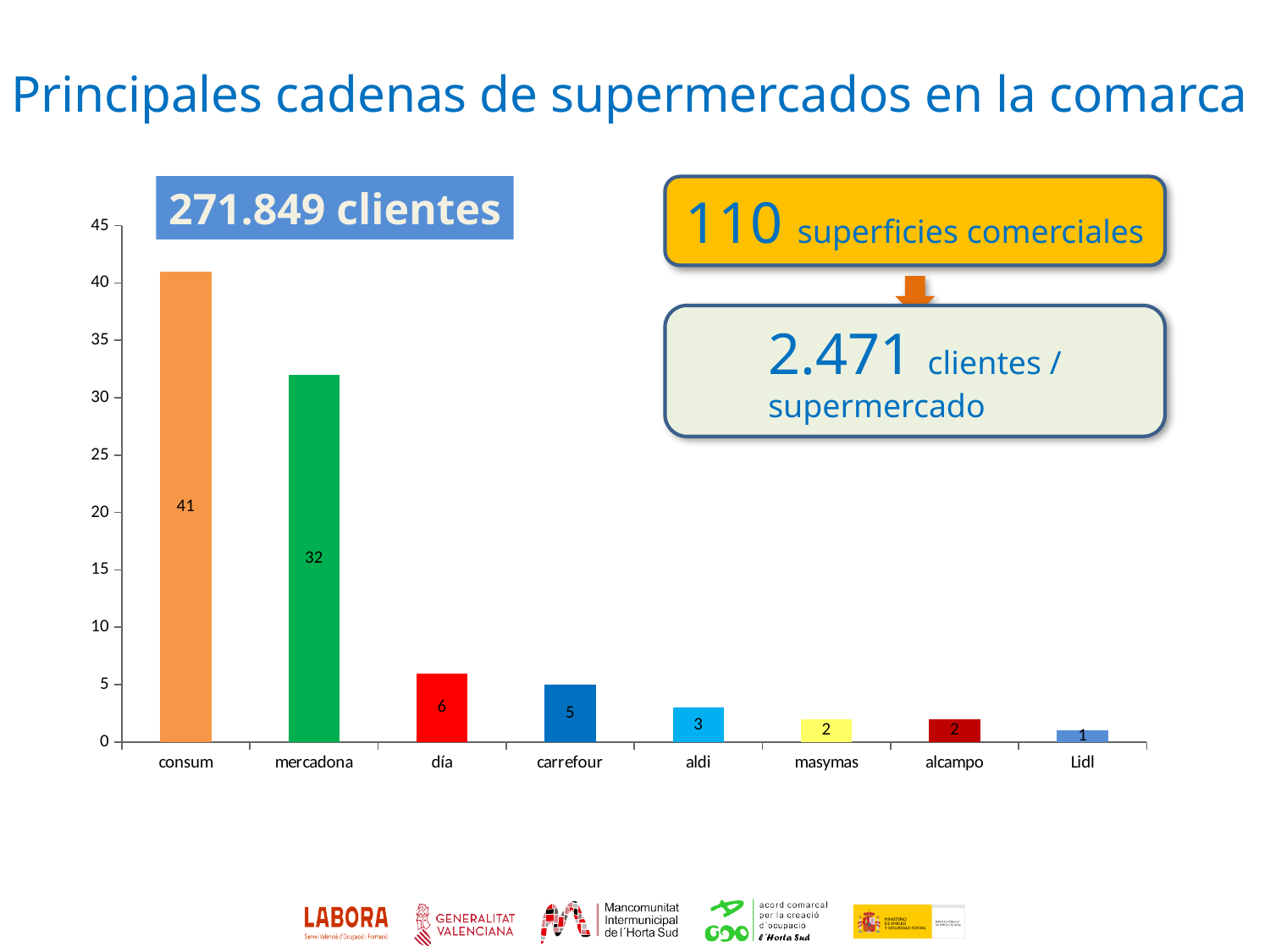
What is the difference between the values for consum and mercadona? 9 What is the value for carrefour? 5 Is the value for mercadona greater or less than 30? greater Do the values rise or fall from left to right along the x axis? fall Which is larger, the value for día or the value for aldi? día What kind of chart is shown on the slide? bar chart What is the value for consum? 41 How many categories are shown on the x axis? 8 Which category has the highest value? consum What is the value for Lidl? 1 What is the value for mercadona? 32 Which category has the lowest value? Lidl